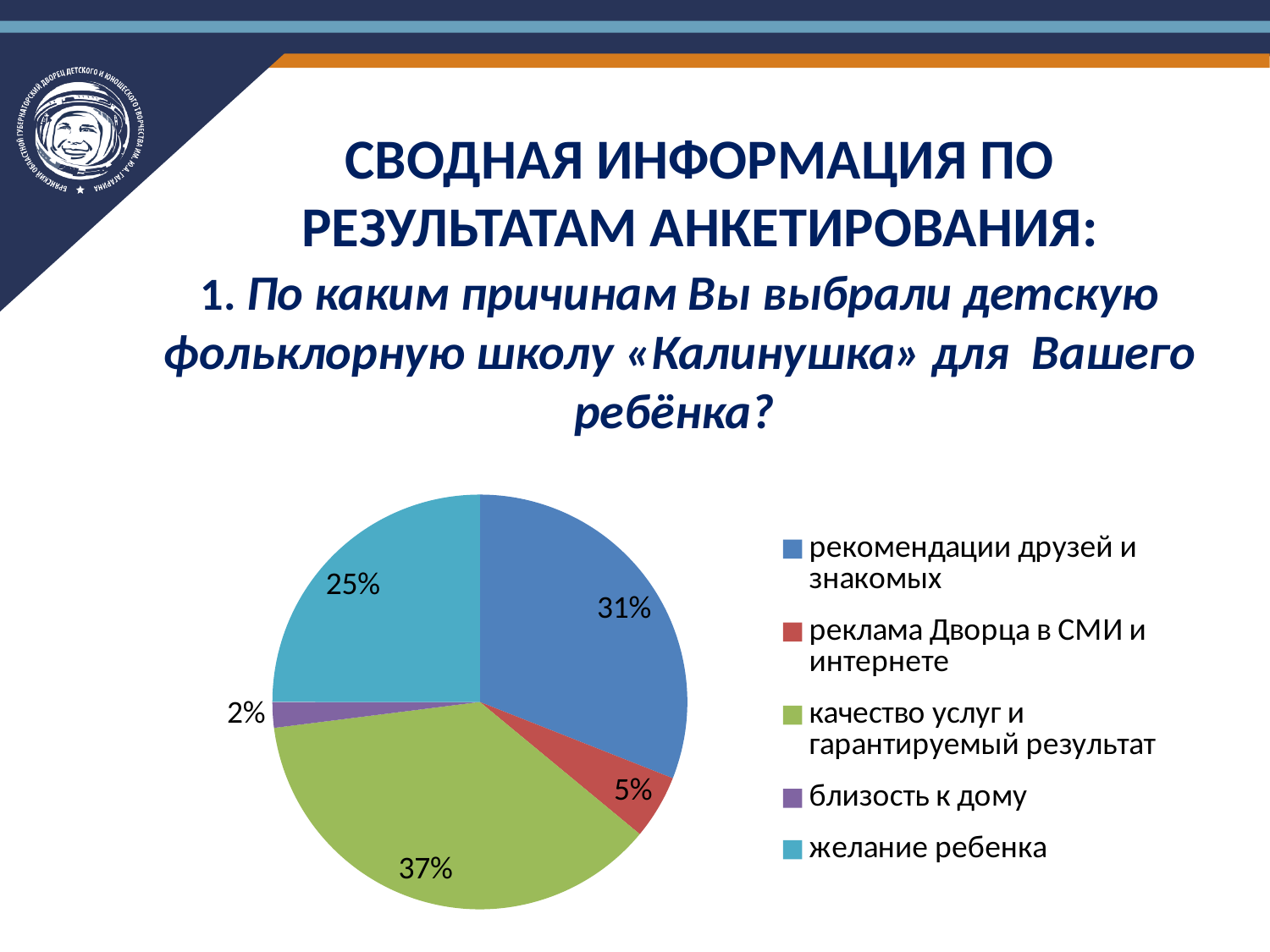
What share of the pie does "желание ребенка" have? 25% How many categories does the pie chart show? 5 What share of the pie does "реклама Дворца в СМИ и интернете" have? 5% Which category has the largest slice of the pie? качество услуг и гарантируемый результат What share of the pie does "качество услуг и гарантируемый результат" have? 37% What kind of chart is shown on the slide? pie chart What colour is the slice for "желание ребенка"? light blue Which is larger: the share for "желание ребенка" or the share for "реклама Дворца в СМИ и интернете"? желание ребенка What is the difference between the shares for "качество услуг и гарантируемый результат" and "рекомендации друзей и знакомых"? 6% Which category has the smallest slice of the pie? близость к дому